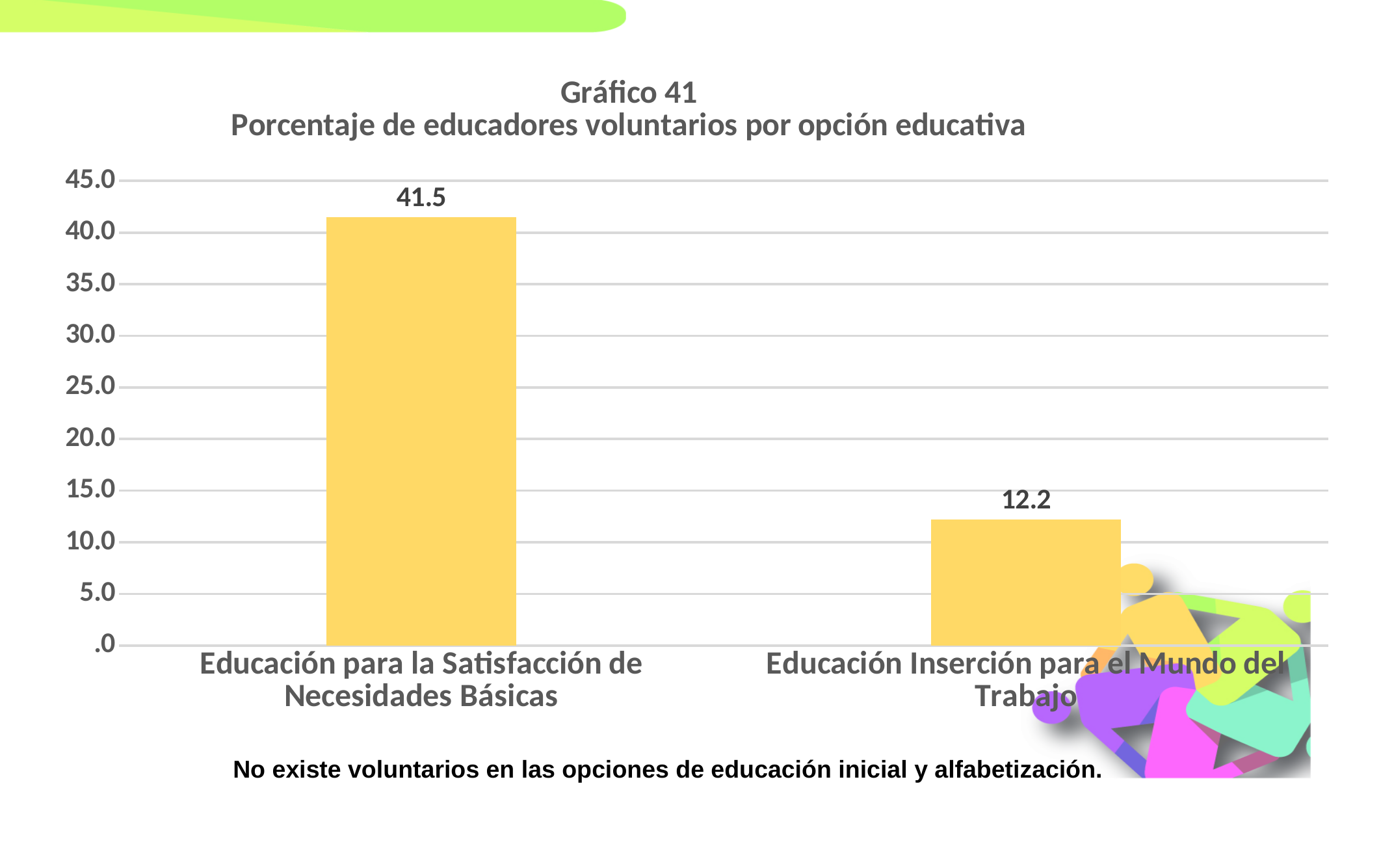
Which category has the highest value? Educación para la Satisfacción de Necesidades Básicas What is the value for Educación Inserción para el Mundo del Trabajo? 12.2 Which is larger: the value for Educación para la Satisfacción de Necesidades Básicas or for Educación Inserción para el Mundo del Trabajo? Educación para la Satisfacción de Necesidades Básicas What is the highest value shown on the vertical axis? 45.0 What is the title of the chart? Gráfico 41 Porcentaje de educadores voluntarios por opción educativa What kind of chart is shown on the slide? Bar chart Is the value for Educación Inserción para el Mundo del Trabajo greater or less than 15.0? less How many categories are shown in the chart? 2 Which category has the lowest value? Educación Inserción para el Mundo del Trabajo What is the difference between the values for Educación para la Satisfacción de Necesidades Básicas and Educación Inserción para el Mundo del Trabajo? 29.3 Is the value for Educación para la Satisfacción de Necesidades Básicas greater or less than 40.0? greater What is the value for Educación para la Satisfacción de Necesidades Básicas? 41.5